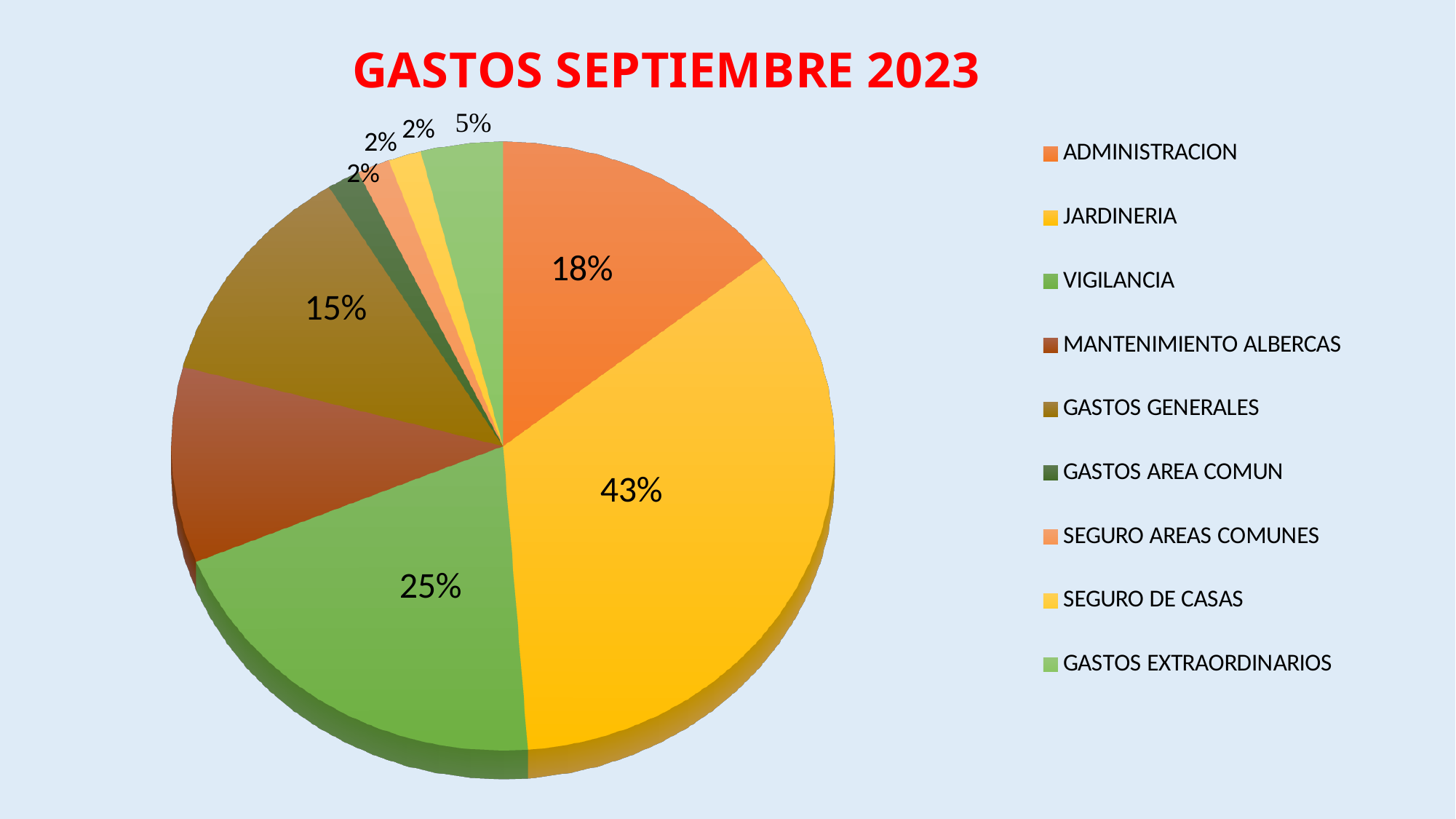
What percentage is shown for ADMINISTRACION? 18% How many categories does the legend list? 9 What percentage is shown for GASTOS EXTRAORDINARIOS? 5% What colour is the slice for JARDINERIA? yellow What percentage is shown for GASTOS GENERALES? 15% Which is larger, the slice for VIGILANCIA or the slice for GASTOS GENERALES? VIGILANCIA Which category has the largest slice of the pie? JARDINERIA What type of chart is shown on the slide? pie chart What is the title of the chart? GASTOS SEPTIEMBRE 2023 What percentage of the pie does JARDINERIA represent? 43% What is the difference in percentage points between JARDINERIA and ADMINISTRACION? 25 What percentage is shown for VIGILANCIA? 25%